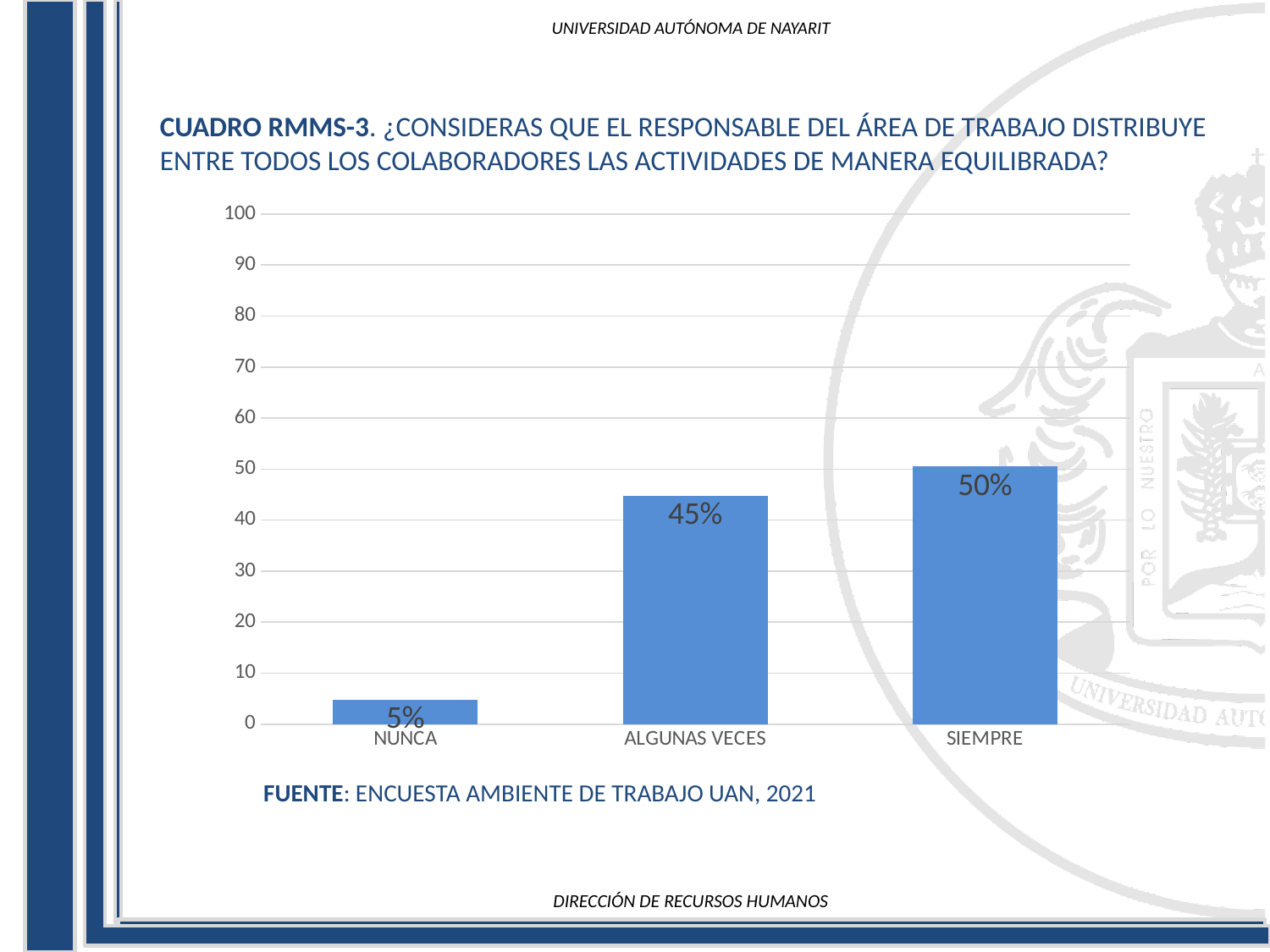
Which category has the highest value? SIEMPRE What is the difference between the values for ALGUNAS VECES and NUNCA? 40% Which category has the lowest value? NUNCA Do the values rise or fall from NUNCA to SIEMPRE along the x axis? rise How many categories are shown on the x axis? 3 What is the difference between the values for SIEMPRE and ALGUNAS VECES? 5% What kind of chart is shown on the slide? bar chart Which is larger, the value for NUNCA or the value for ALGUNAS VECES? ALGUNAS VECES What is the value for ALGUNAS VECES? 45% What is the value for NUNCA? 5% What is the value for SIEMPRE? 50% Is the value for ALGUNAS VECES greater or less than 40? greater